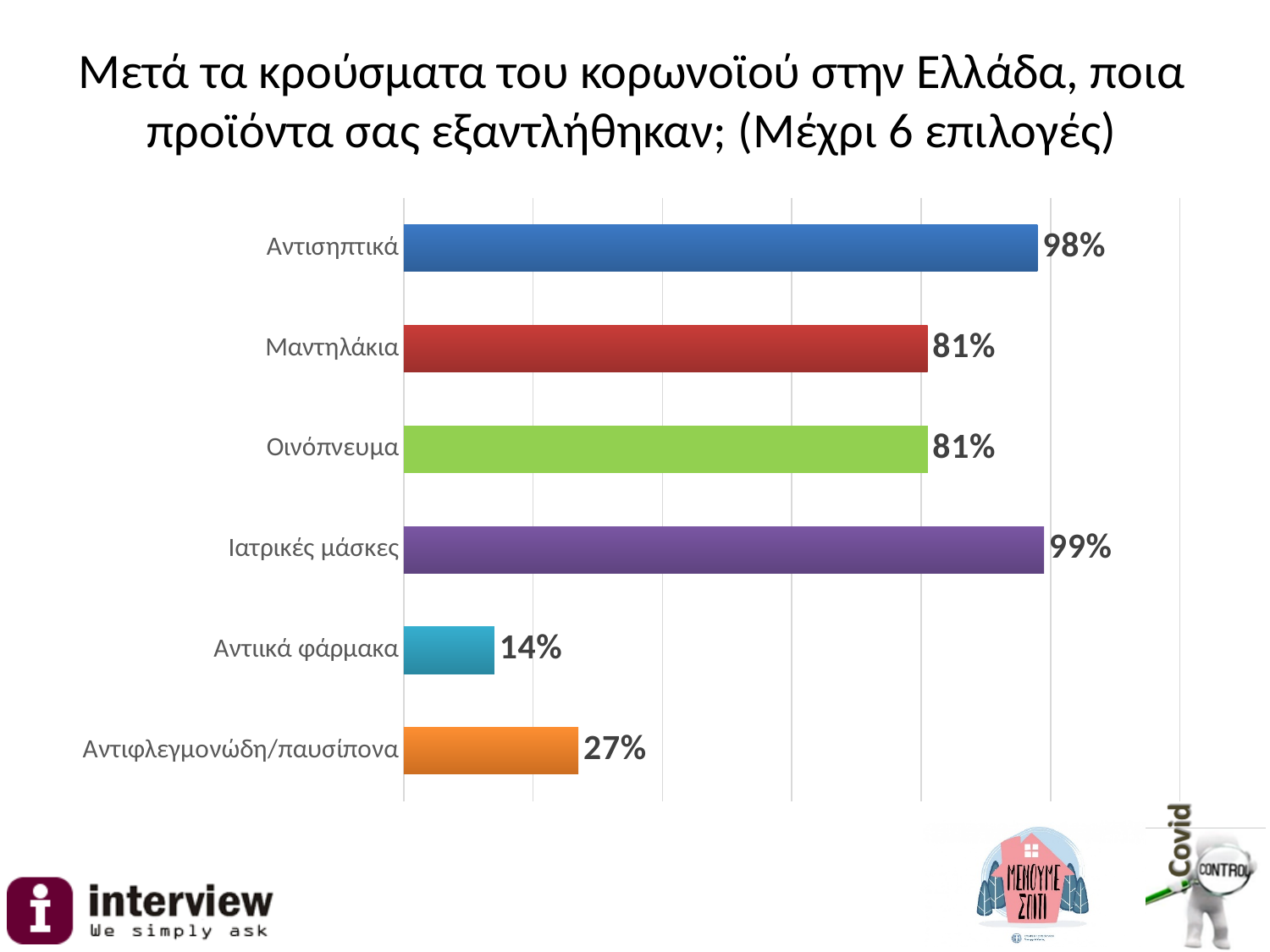
How many product categories are shown in the chart? 6 Which is larger, the value for Μαντηλάκια or the value for Αντιφλεγμονώδη/παυσίπονα? Μαντηλάκια What is the value for Ιατρικές μάσκες? 99% What percentage is shown for Αντισηπτικά? 98% What kind of chart is shown on the slide? Bar chart What is the value for Αντιφλεγμονώδη/παυσίπονα? 27% Which product has the lowest percentage? Αντιικά φάρμακα What percentage is shown for Αντιικά φάρμακα? 14% Which product has the highest percentage? Ιατρικές μάσκες What percentage is shown for Οινόπνευμα? 81% What colour is the bar for Ιατρικές μάσκες? Purple What is the difference between the values for Αντισηπτικά and Αντιικά φάρμακα? 84%